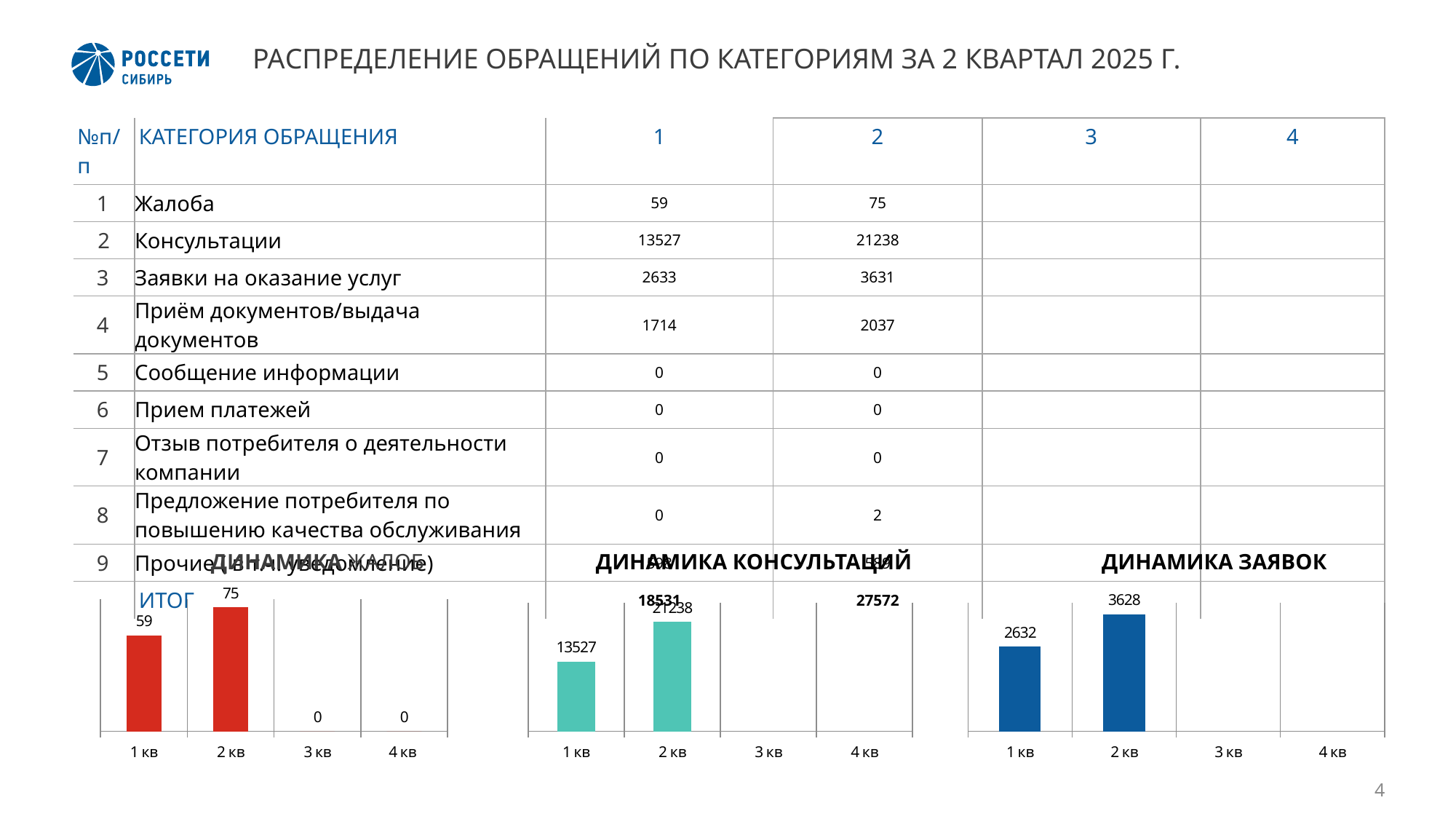
In the ДИНАМИКА ЗАЯВОК chart, what is the value for 1 кв? 2632 What type of chart is the ДИНАМИКА КОНСУЛЬТАЦИЙ chart? Bar chart In the ДИНАМИКА КОНСУЛЬТАЦИЙ chart, what is the value for 1 кв? 13527 In the ДИНАМИКА ЗАЯВОК chart, what is the value for 2 кв? 3628 In the ДИНАМИКА ЗАЯВОК chart, what is the difference between the values for 2 кв and 1 кв? 996 How many quarter categories are shown on the x axis of the ДИНАМИКА ЗАЯВОК chart? 4 In the ДИНАМИКА ЖАЛОБ chart, what is the value for 1 кв? 59 What colour are the bars in the ДИНАМИКА ЖАЛОБ chart? Red In the ДИНАМИКА КОНСУЛЬТАЦИЙ chart, which quarter has the higher value, 1 кв or 2 кв? 2 кв In the ДИНАМИКА КОНСУЛЬТАЦИЙ chart, what is the value for 2 кв? 21238 In the ДИНАМИКА ЖАЛОБ chart, what is the difference between the values for 2 кв and 1 кв? 16 In the ДИНАМИКА ЖАЛОБ chart, what is the value for 2 кв? 75